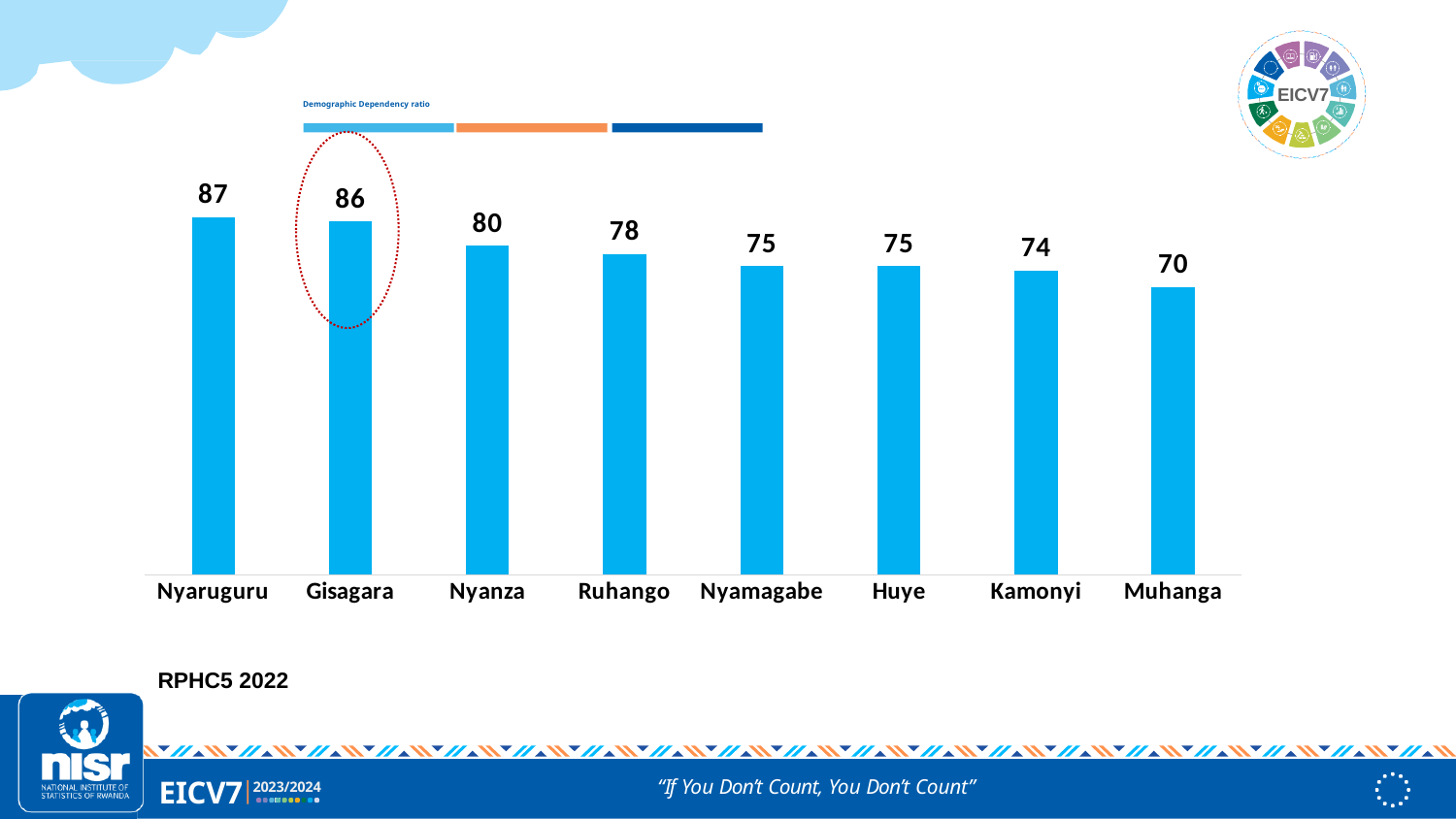
What is the demographic dependency ratio for Muhanga? 70 Which district has the lowest demographic dependency ratio? Muhanga What is the demographic dependency ratio for Nyaruguru? 87 Do the values rise or fall from left to right across the districts? Fall Which district has the highest demographic dependency ratio? Nyaruguru Which district has a higher demographic dependency ratio, Nyanza or Huye? Nyanza What is the difference between the demographic dependency ratios of Nyanza and Kamonyi? 6 What is the demographic dependency ratio for Ruhango? 78 What is the difference between the demographic dependency ratios of Nyaruguru and Muhanga? 17 What is the demographic dependency ratio for Gisagara? 86 What kind of chart is shown on the slide? Bar chart How many districts are shown in the chart? 8